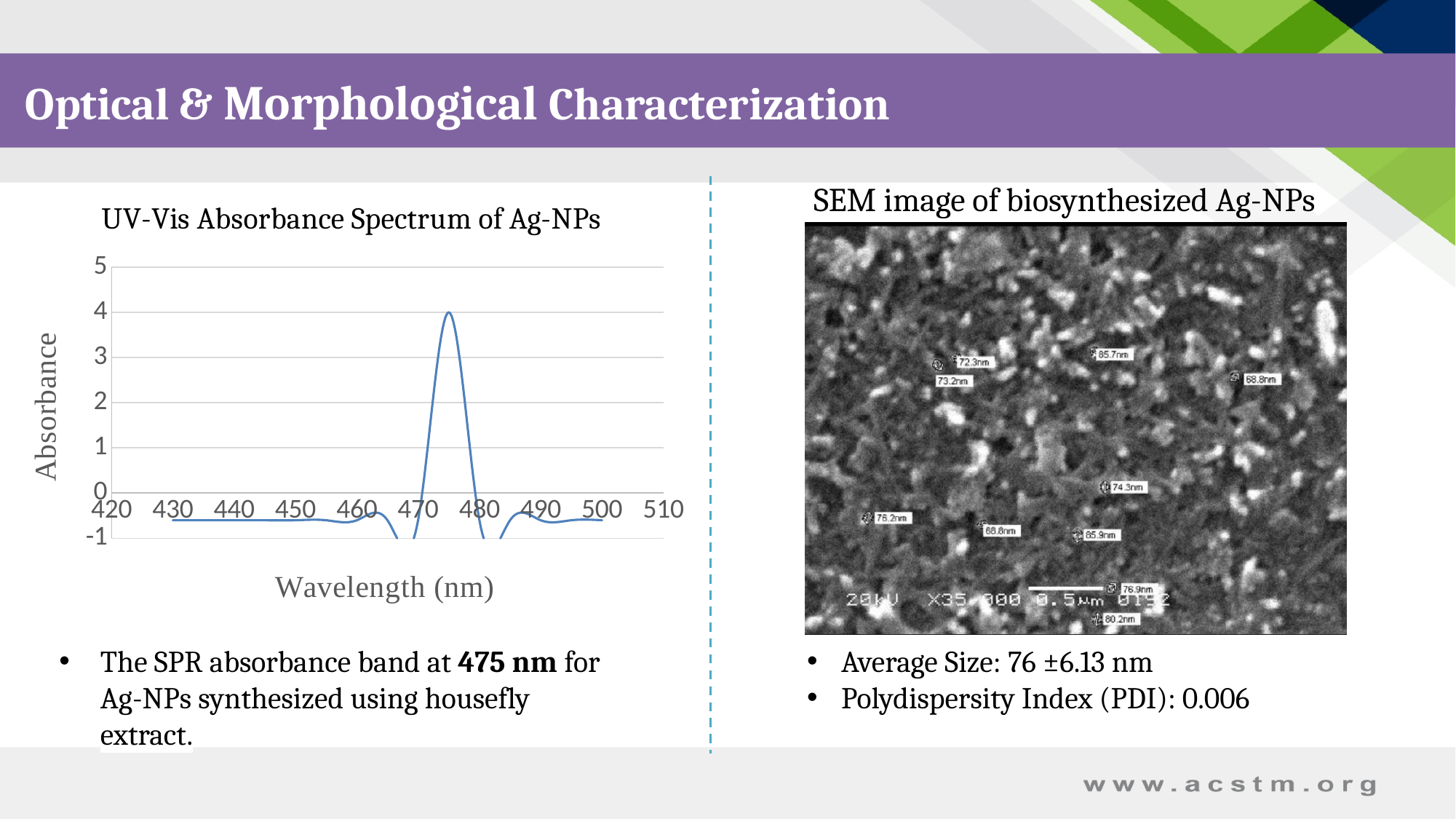
Is the absorbance at 440 nm in the UV-Vis chart greater or less than 0? less What kind of chart is the UV-Vis Absorbance Spectrum of Ag-NPs? line chart What is the title of the chart on the left of the slide? UV-Vis Absorbance Spectrum of Ag-NPs What is the label of the x axis of the UV-Vis absorbance chart? Wavelength (nm) Does the absorbance rise or fall between 475 nm and 480 nm in the UV-Vis chart? fall Is the peak absorbance in the UV-Vis chart greater or less than 3? greater Is the absorbance at 500 nm in the UV-Vis chart greater or less than 1? less At which wavelength does the absorbance reach its highest value in the UV-Vis chart? 475 nm Does the absorbance rise or fall between 470 nm and 475 nm in the UV-Vis chart? rise What is the highest value shown on the y axis of the UV-Vis absorbance chart? 5 Is the absorbance at 475 nm greater or less than the absorbance at 450 nm in the UV-Vis chart? greater